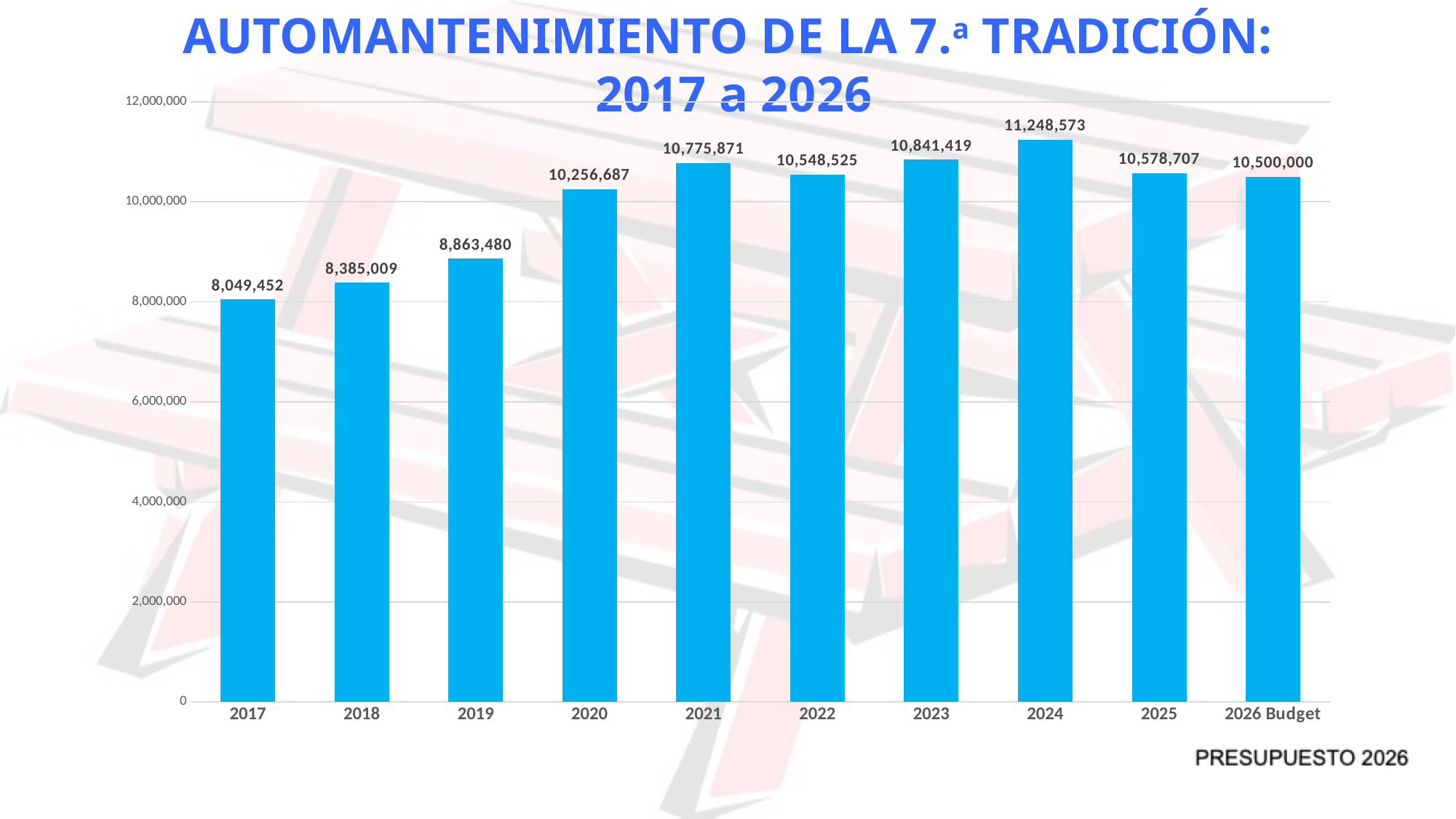
What is the difference between the values for 2018 and 2017? 335,557 Which is larger, the value for 2021 or the value for 2022? 2021 What kind of chart is shown on the slide? bar chart Is the value for 2019 greater or less than 10,000,000? less How many bars are shown in the chart? 10 What is the value for 2017? 8,049,452 Which year has the lowest value? 2017 What is the value for 2024? 11,248,573 What is the difference between the values for 2024 and 2017? 3,199,121 What is the value for 2020? 10,256,687 What is the value for 2026 Budget? 10,500,000 Which year has the highest value? 2024